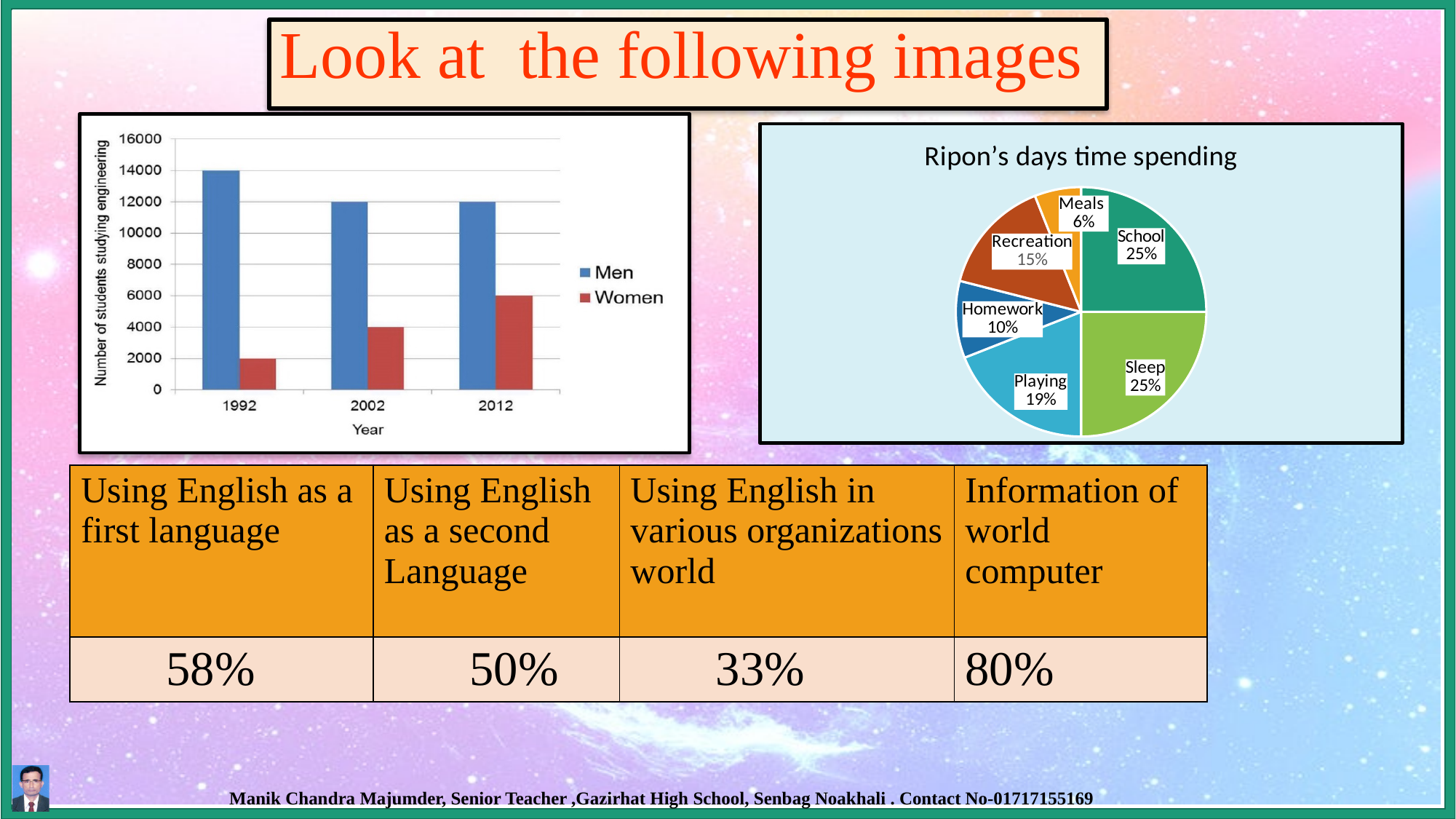
In the pie chart 'Ripon's days time spending', which is larger, Recreation or Homework? Recreation In the bar chart on the left, in which year is the number of women studying engineering lowest? 1992 In the pie chart 'Ripon's days time spending', how many categories are shown? 6 What kind of chart is the chart on the left showing students studying engineering? bar chart In the bar chart on the left, what is the difference between the number of men and women studying engineering in 2002? 8000 In the pie chart 'Ripon's days time spending', which category has the smallest share? Meals In the pie chart 'Ripon's days time spending', what is the difference between the shares for School and Meals? 19% In the bar chart on the left, does the number of women studying engineering rise or fall from 1992 to 2012? rise In the bar chart on the left, what is the number of women studying engineering in 2012? 6000 In the pie chart 'Ripon's days time spending', what share is Playing? 19% In the bar chart on the left, what is the number of men studying engineering in 1992? 14000 In the bar chart on the left, how many series does the legend list? 2